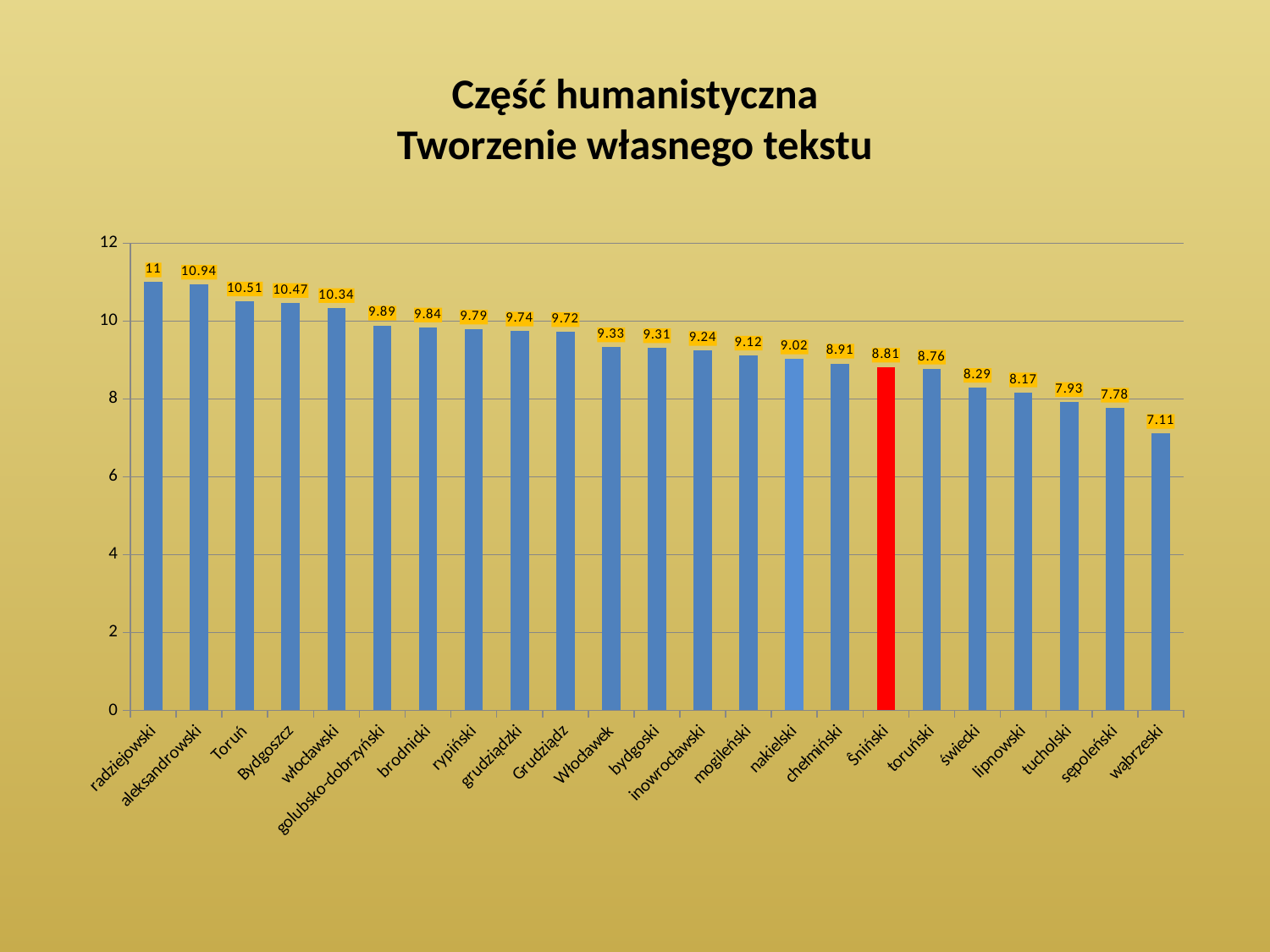
Which category has the highest value? radziejowski What is the value for Bydgoszcz? 10.47 Which is larger, the value for brodnicki or the value for lipnowski? brodnicki How many categories are shown on the x axis? 23 What kind of chart is shown on the slide? bar chart What is the value for chełmiński? 8.91 What is the difference between the values for Toruń and Włocławek? 1.18 What is the value for radziejowski? 11 Is the value for sępoleński greater or less than 8? less What is the value shown on the red bar? 8.81 Do the values rise or fall from left to right along the x axis? fall Which category has the lowest value? wąbrzeski